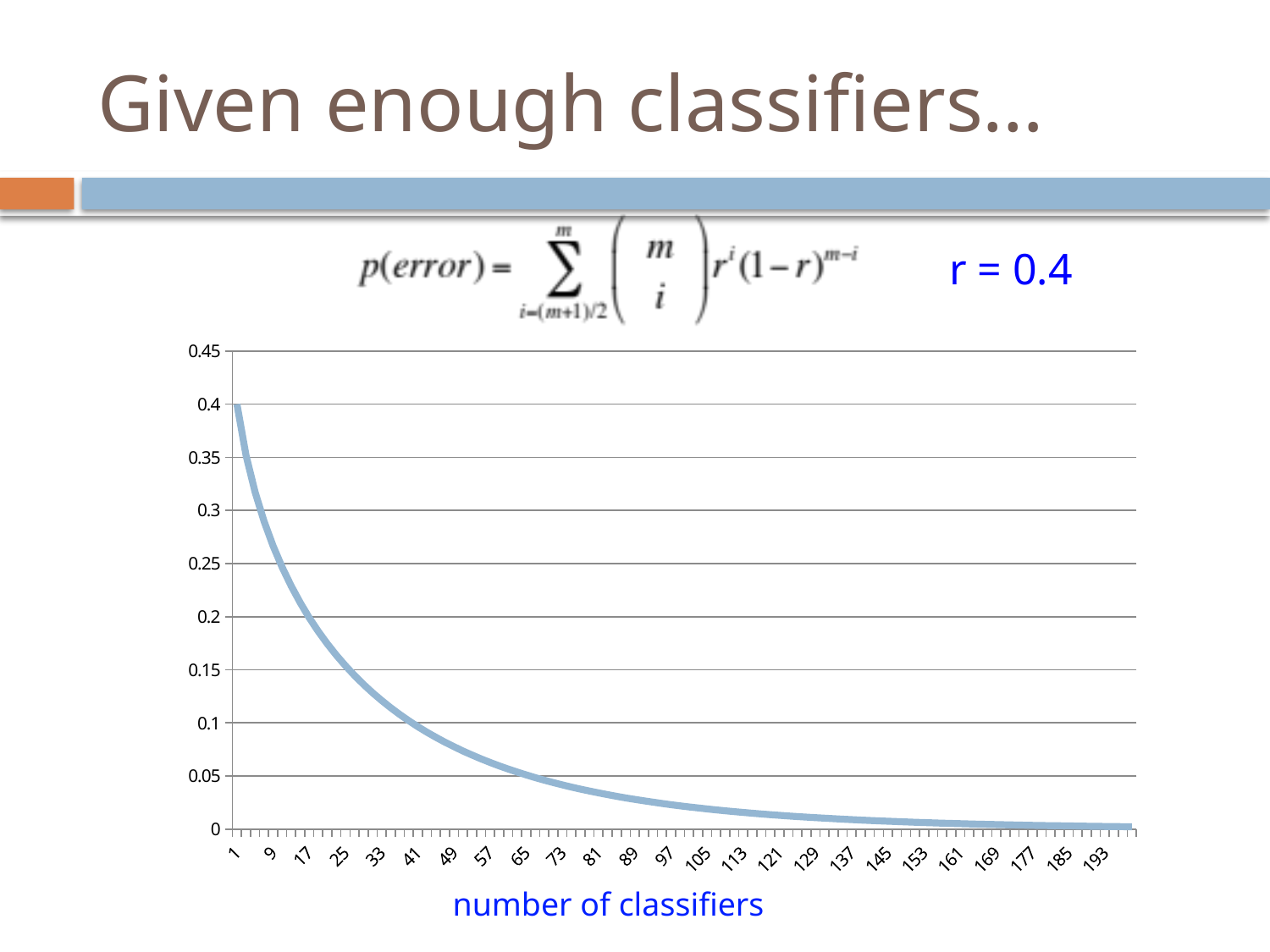
What kind of chart is shown on the slide? line chart How many tick labels are shown on the x axis? 25 What is the value of p(error) when the number of classifiers is 1? 0.4 Which is larger: p(error) at 9 classifiers or at 57 classifiers? 9 classifiers At which labelled number of classifiers is p(error) lowest? 193 What value of r is stated for the plotted curve? r = 0.4 Is the value of p(error) at 33 classifiers greater or less than 0.2? less What is the label of the x axis? number of classifiers Is the value of p(error) at 97 classifiers greater or less than 0.05? less At which number of classifiers is p(error) highest? 1 Does p(error) rise or fall as the number of classifiers increases? fall Is the value of p(error) at 9 classifiers greater or less than 0.25? greater